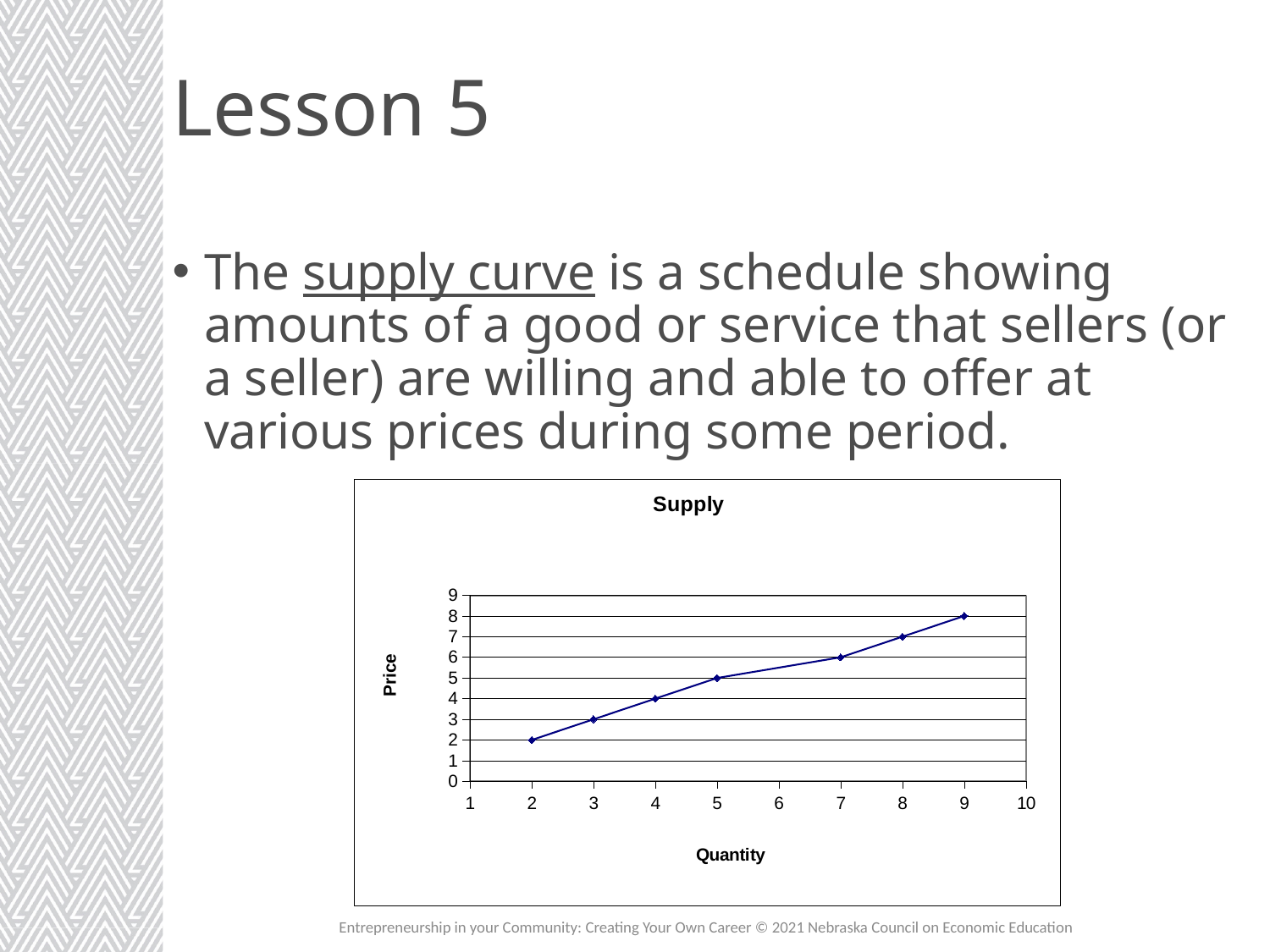
What is the price at a quantity of 7? 6 At which quantity is the price highest? 9 What is the title of the chart? Supply At which quantity is the price lowest? 2 Does the price rise or fall as quantity increases along the x axis? rise What is the difference between the price at quantity 9 and the price at quantity 2? 6 How many data points are plotted on the line? 7 What is the price at a quantity of 2? 2 What kind of chart is shown on the slide? line chart What is the price at a quantity of 5? 5 What is the price at a quantity of 9? 8 What is the label of the vertical axis? Price